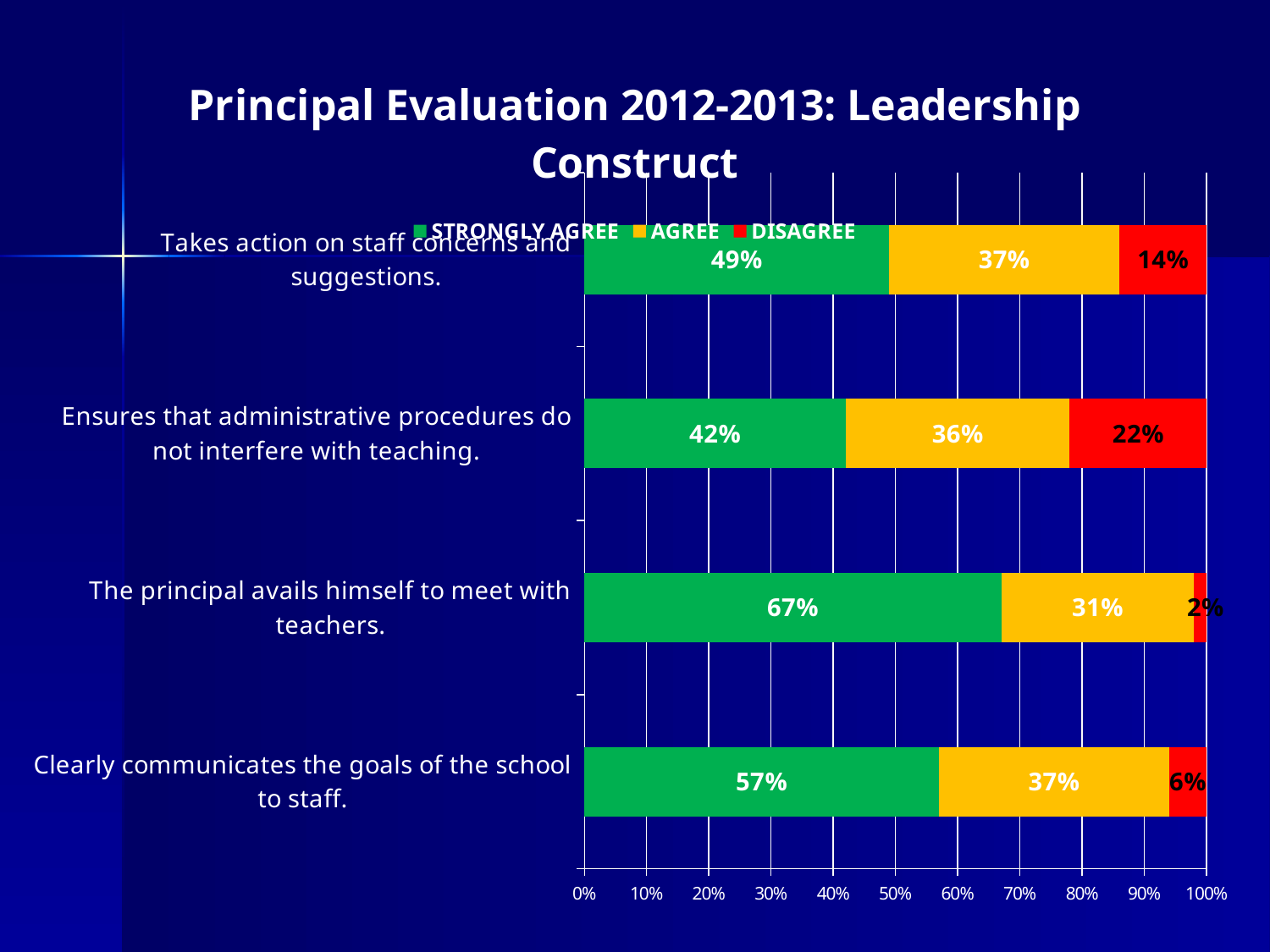
How many statements (categories) are shown in the chart? 4 How many series does the legend list? 3 What is the combined Strongly Agree and Agree percentage for 'Clearly communicates the goals of the school to staff'? 94% Which statement has the highest Strongly Agree percentage? The principal avails himself to meet with teachers. What is the Disagree value for 'Ensures that administrative procedures do not interfere with teaching'? 22% Which is larger: the Disagree value for 'Takes action on staff concerns and suggestions' or for 'Clearly communicates the goals of the school to staff'? Takes action on staff concerns and suggestions. What kind of chart is shown on the slide? Stacked bar chart What is the title of the chart? Principal Evaluation 2012-2013: Leadership Construct What is the Agree value for 'Takes action on staff concerns and suggestions'? 37% What percentage of respondents strongly agree that the principal avails himself to meet with teachers? 67% What is the difference between the Strongly Agree values for 'Clearly communicates the goals of the school to staff' and 'Ensures that administrative procedures do not interfere with teaching'? 15% Which statement has the lowest Disagree percentage? The principal avails himself to meet with teachers.